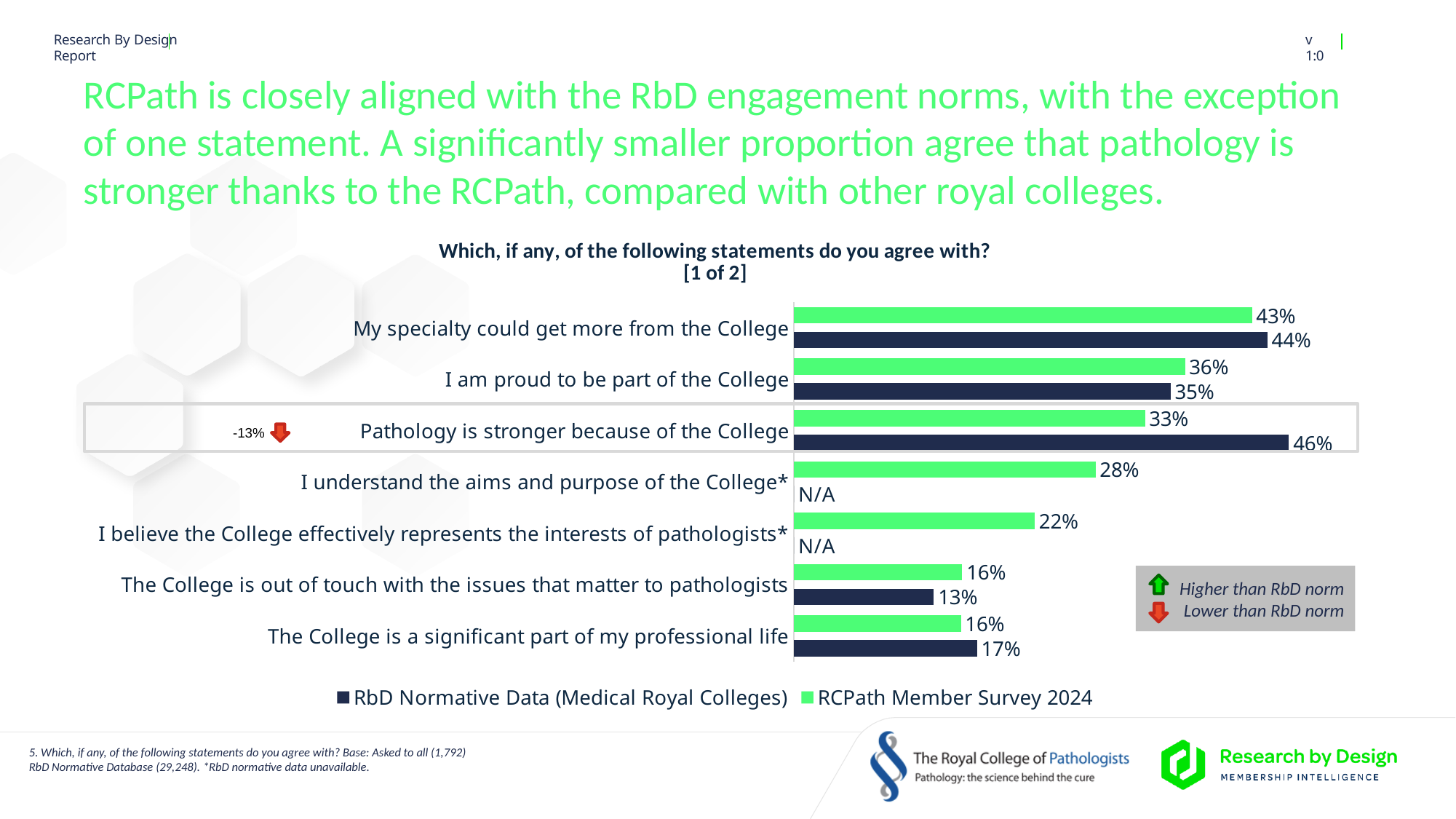
How many series does the legend list? 2 What is the RCPath Member Survey 2024 value for 'I understand the aims and purpose of the College*'? 28% Which statement has the highest RCPath Member Survey 2024 value? My specialty could get more from the College What is shown for the RbD Normative Data for 'I believe the College effectively represents the interests of pathologists*'? N/A What is the difference between the RbD Normative Data and RCPath Member Survey 2024 values for 'Pathology is stronger because of the College'? 13% For 'The College is out of touch with the issues that matter to pathologists', which series has the larger value: RbD Normative Data or RCPath Member Survey 2024? RCPath Member Survey 2024 What is the RbD Normative Data value for 'Pathology is stronger because of the College'? 46% What percentage of RCPath Member Survey 2024 respondents agree that 'My specialty could get more from the College'? 43% What type of chart is shown on the slide? Bar chart Which statement is marked with a red arrow as lower than the RbD norm? Pathology is stronger because of the College How many statements are listed in the chart? 7 Which statement has the lowest RbD Normative Data value? The College is out of touch with the issues that matter to pathologists